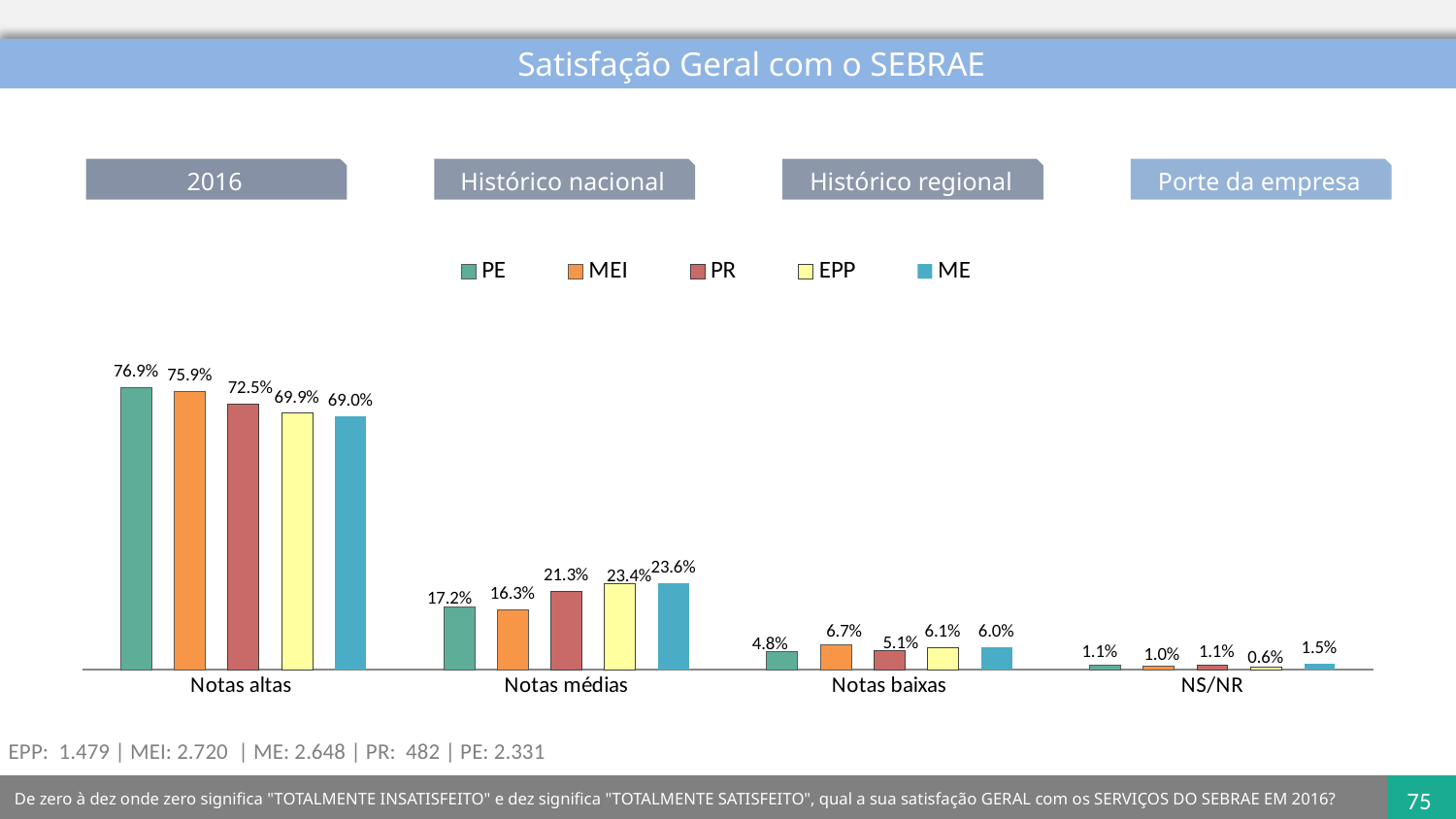
Which is larger in the Notas médias category, the value for PR or the value for MEI? PR What kind of chart is shown on the slide? Bar chart How many categories are shown on the x axis? 4 What is the title of the slide? Satisfação Geral com o SEBRAE What is the value for MEI in the Notas baixas category? 6.7% What is the value for PE in the Notas altas category? 76.9% Which series has the lowest value in the NS/NR category? EPP What is the value for ME in the NS/NR category? 1.5% Which series has the highest value in the Notas altas category? PE What is the difference between the PE and ME values in the Notas altas category? 7.9% What is the value for EPP in the Notas médias category? 23.4% How many series does the legend list? 5